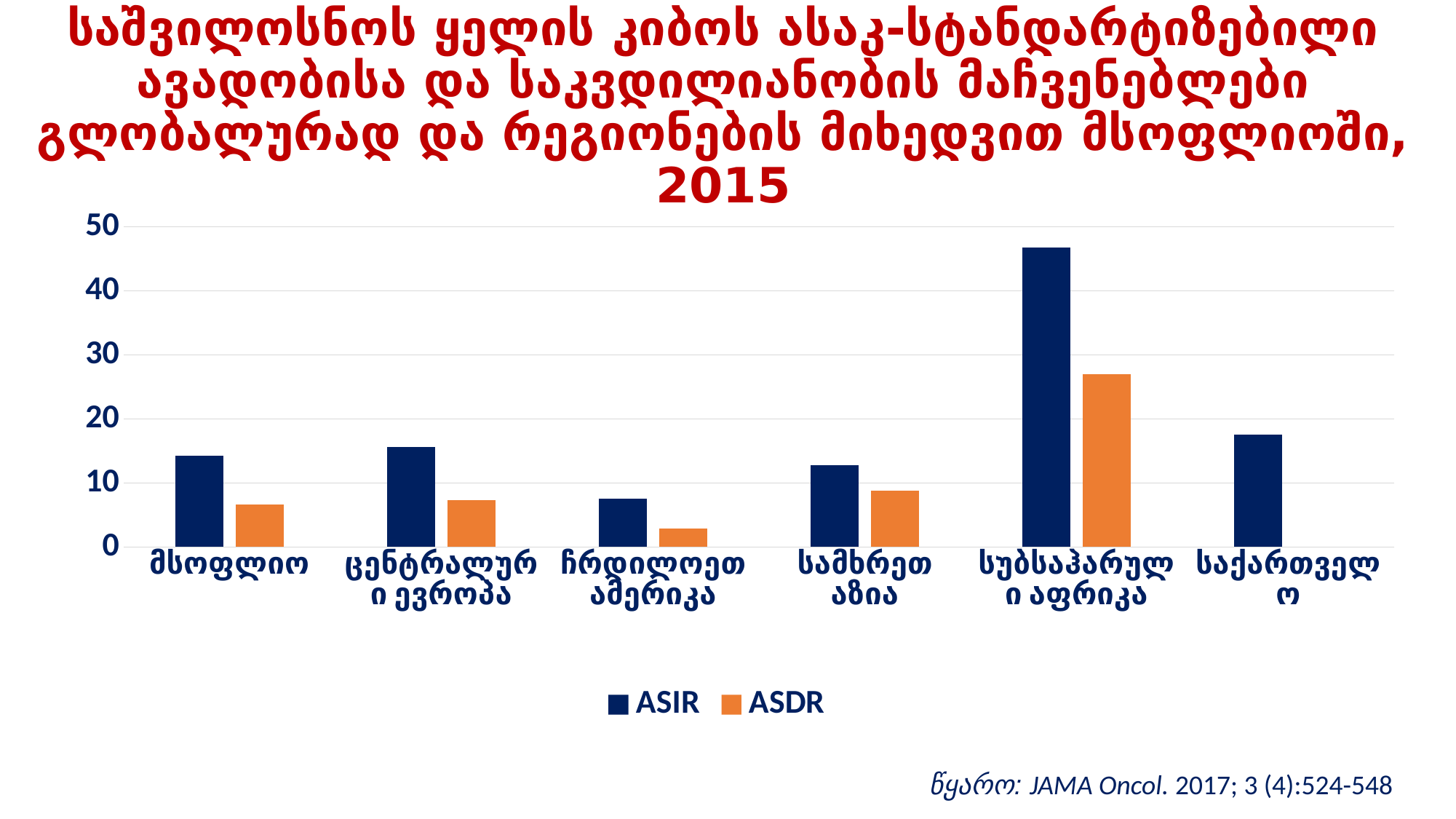
Which category has the highest ASDR value? სუბსაჰარული აფრიკა Which category has the highest ASIR value? სუბსაჰარული აფრიკა Which category has the lowest ASIR value? ჩრდილოეთ ამერიკა Is the ASIR value for სუბსაჰარული აფრიკა greater or less than 40? greater What are the two series names listed in the legend? ASIR and ASDR How many series does the legend list? 2 Is the ASIR value for საქართველო greater or less than 20? less What kind of chart is shown on the slide? bar chart Which is larger, the ASDR value for სამხრეთ აზია or the ASDR value for ჩრდილოეთ ამერიკა? სამხრეთ აზია Is the ASDR value for ჩრდილოეთ ამერიკა greater or less than 10? less How many categories are shown on the x axis? 6 Which is larger, the ASIR value for საქართველო or the ASIR value for მსოფლიო? საქართველო